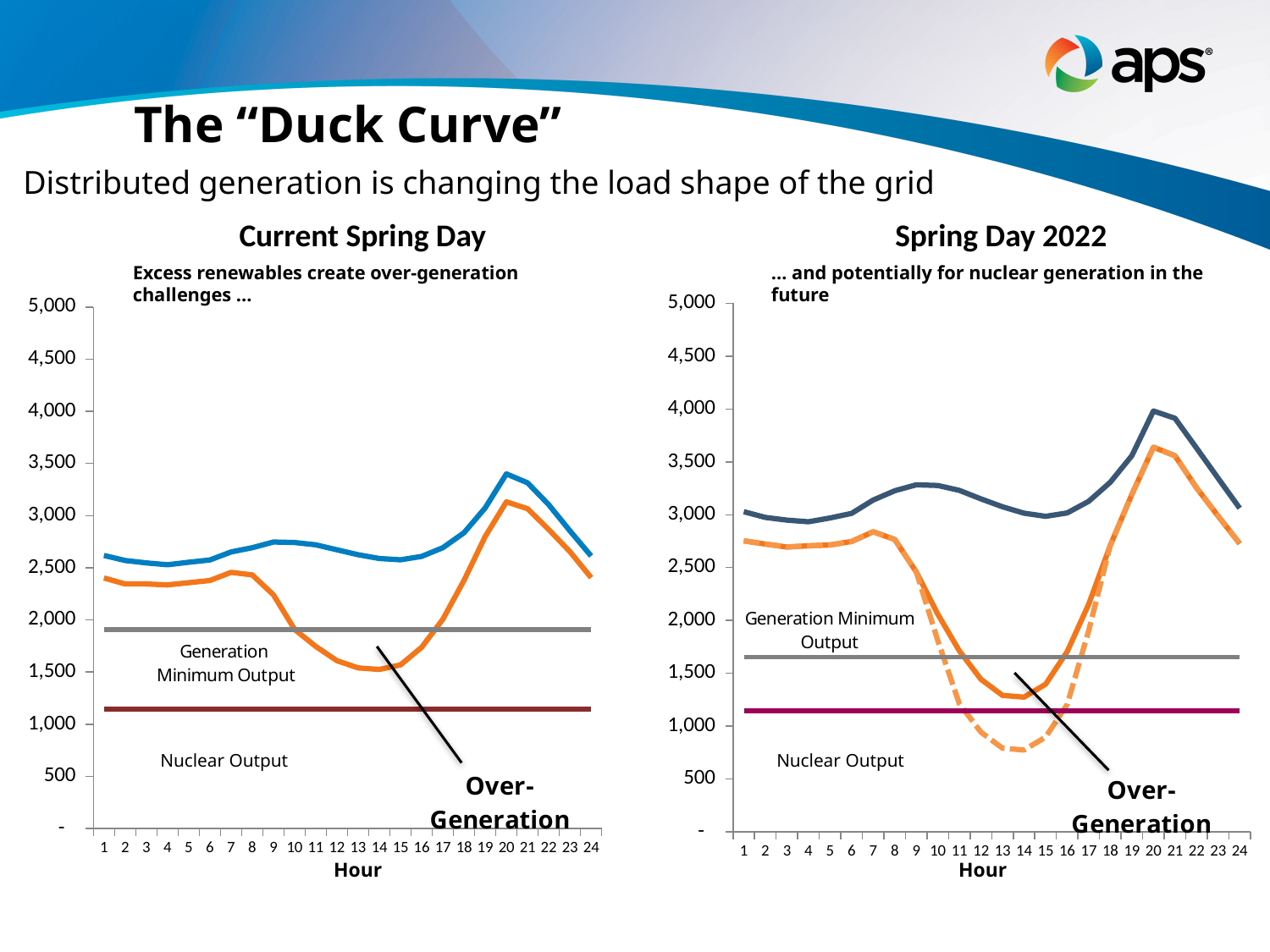
In the "Current Spring Day" chart, is the blue line higher at hour 20 or at hour 1? Hour 20 What is the x-axis label on the "Current Spring Day" chart? Hour How many hours are plotted along the x axis of the "Spring Day 2022" chart? 24 In the "Current Spring Day" chart, is the Generation Minimum Output line greater or less than 2,000? less In the "Spring Day 2022" chart, is the value of the dark blue line at hour 20 greater or less than 3,500? greater In the "Spring Day 2022" chart, is the value of the dashed orange line at hour 14 greater or less than 1,000? less In the "Current Spring Day" chart, at which hour does the blue line reach its highest value? Hour 20 In the "Spring Day 2022" chart, does the solid orange line rise or fall between hour 8 and hour 14? Fall What kind of chart is the "Current Spring Day" chart? Line chart